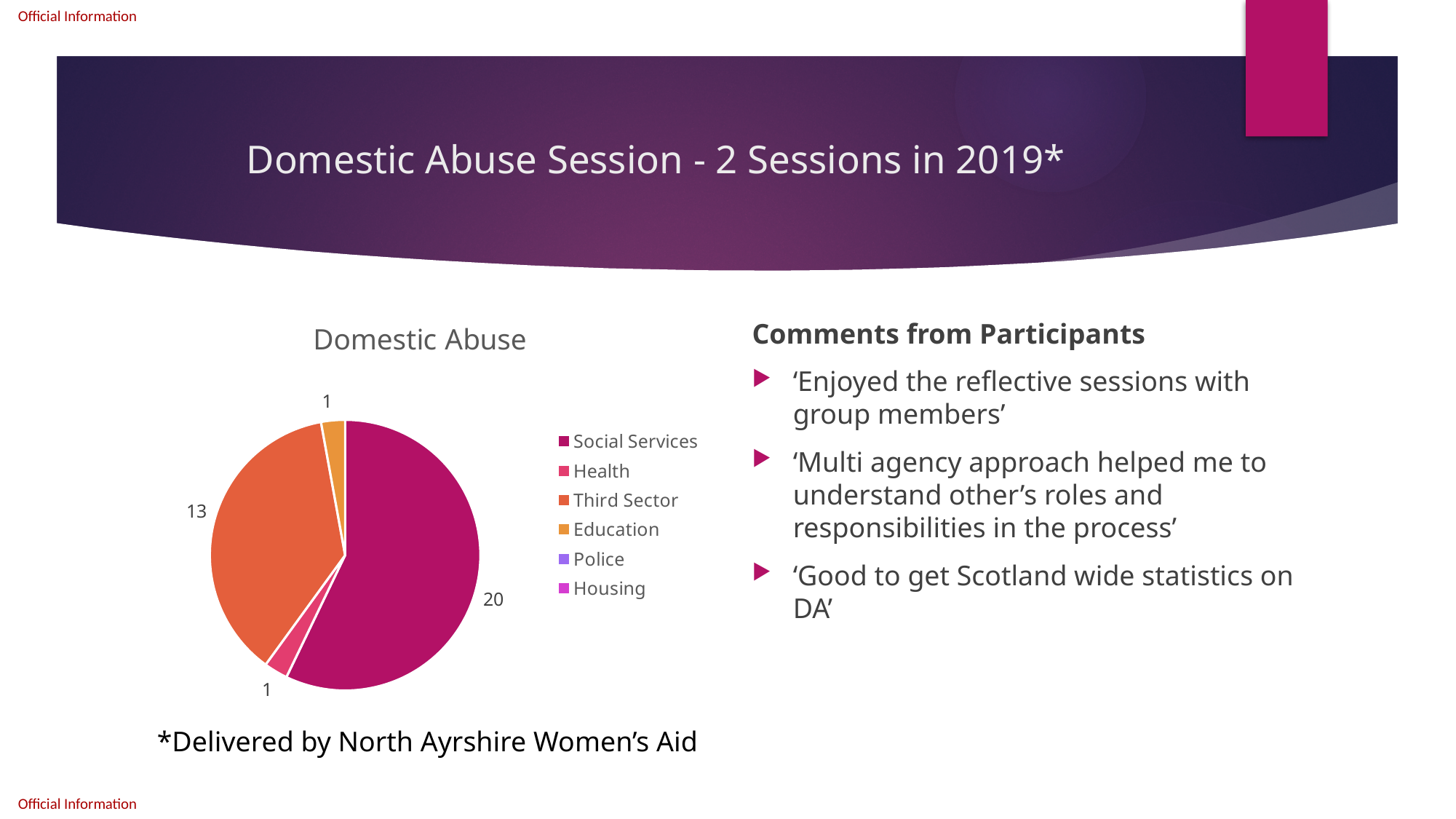
What is the difference between the Social Services and Third Sector values in the Domestic Abuse pie chart? 7 Which category has the largest slice in the Domestic Abuse pie chart? Social Services What is the title of the chart on the slide? Domestic Abuse What is the difference between the Third Sector and Health values in the Domestic Abuse pie chart? 12 What is the value for Social Services in the Domestic Abuse pie chart? 20 What kind of chart is shown on the slide? Pie chart Which is larger in the Domestic Abuse pie chart, Social Services or Third Sector? Social Services How many categories does the legend of the Domestic Abuse chart list? 6 What colour represents Third Sector in the Domestic Abuse pie chart? Orange What is the value for Third Sector in the Domestic Abuse pie chart? 13 What is the value for Health in the Domestic Abuse pie chart? 1 What is the value for Education in the Domestic Abuse pie chart? 1